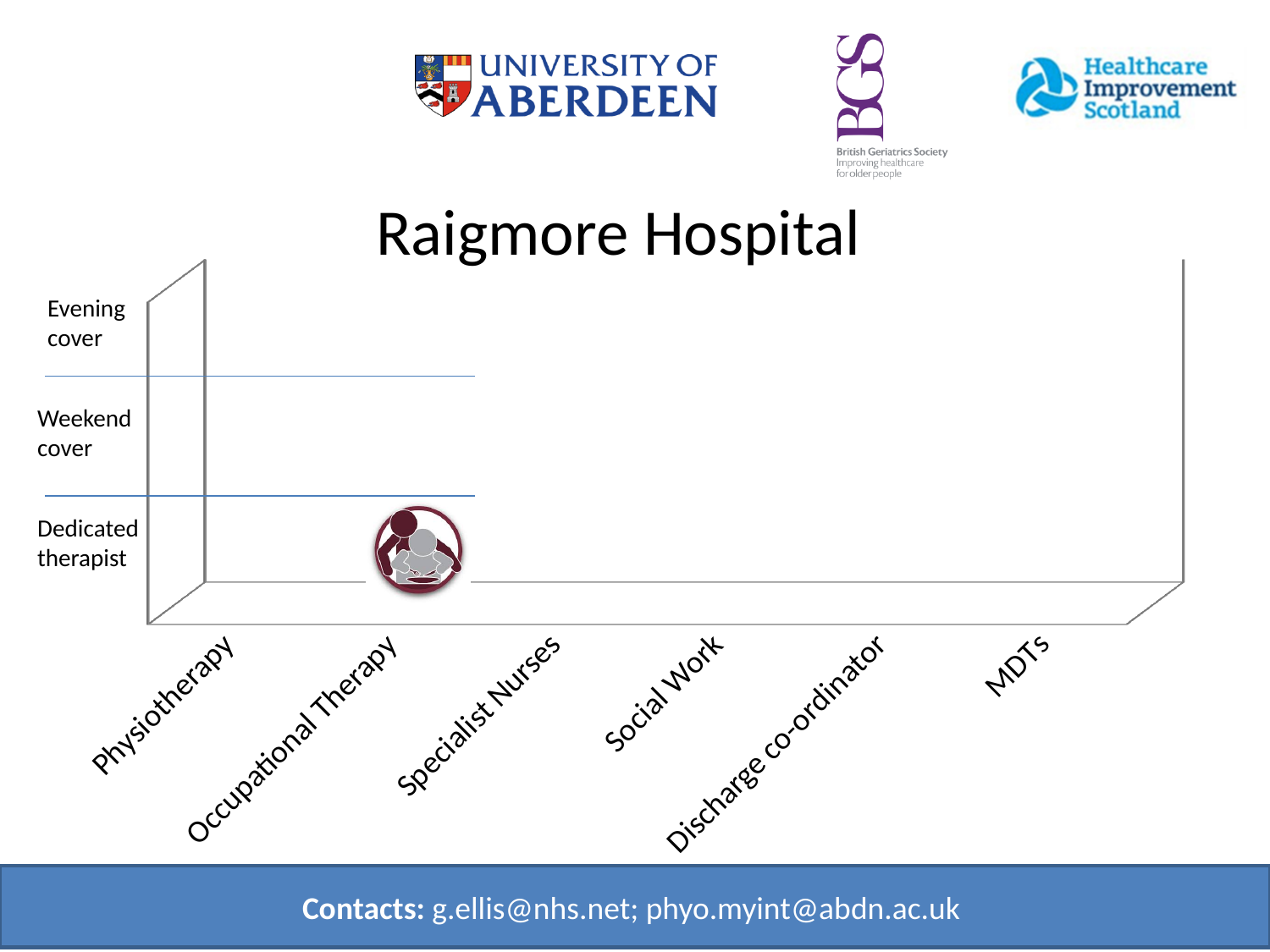
What is the first category listed on the x axis? Physiotherapy Which category appears between 'Social Work' and 'MDTs' on the x axis? Discharge co-ordinator What is the last category listed on the x axis? MDTs Which vertical-axis level lies between 'Dedicated therapist' and 'Evening cover'? Weekend cover How many categories are listed along the x axis of the chart? 6 What is the title of the chart? Raigmore Hospital What is the highest level labelled on the vertical axis? Evening cover How many levels are labelled on the vertical axis of the chart? 3 Which category on the x axis has an icon placed at the 'Dedicated therapist' level? Occupational Therapy